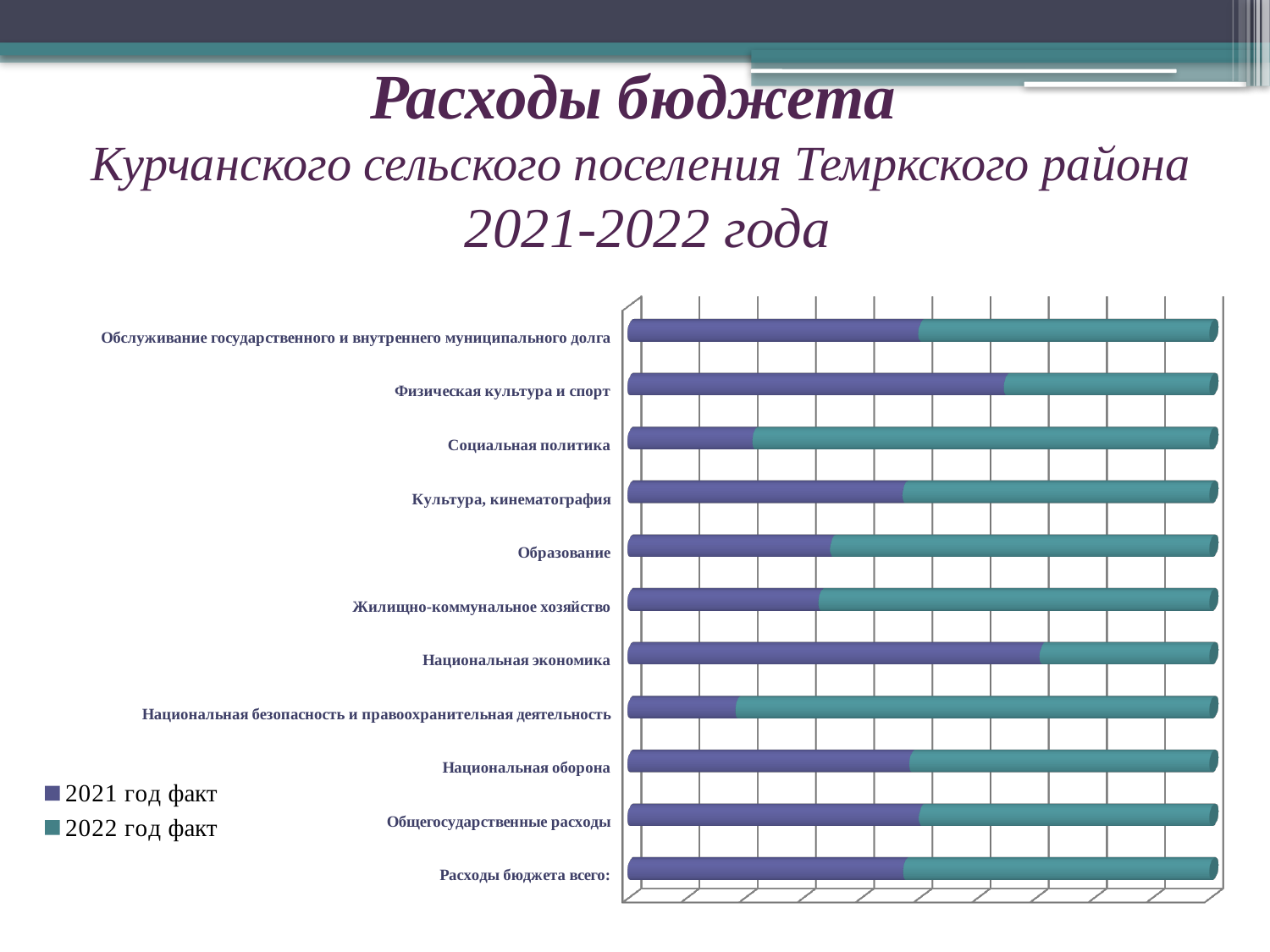
For Социальная политика, which series has the larger share: 2021 год факт or 2022 год факт? 2022 год факт Which category has a larger 2022 год факт share: Социальная политика or Культура, кинематография? Социальная политика For Национальная безопасность и правоохранительная деятельность, which series has the larger share: 2021 год факт or 2022 год факт? 2022 год факт Which category has the largest share for 2021 год факт? Национальная экономика What are the two series named in the legend? 2021 год факт and 2022 год факт Which category has the smallest share for 2022 год факт? Национальная экономика How many series does the legend list? 2 What kind of chart is shown on the slide? bar chart How many categories are plotted on the chart? 11 What is the main title of the slide? Расходы бюджета